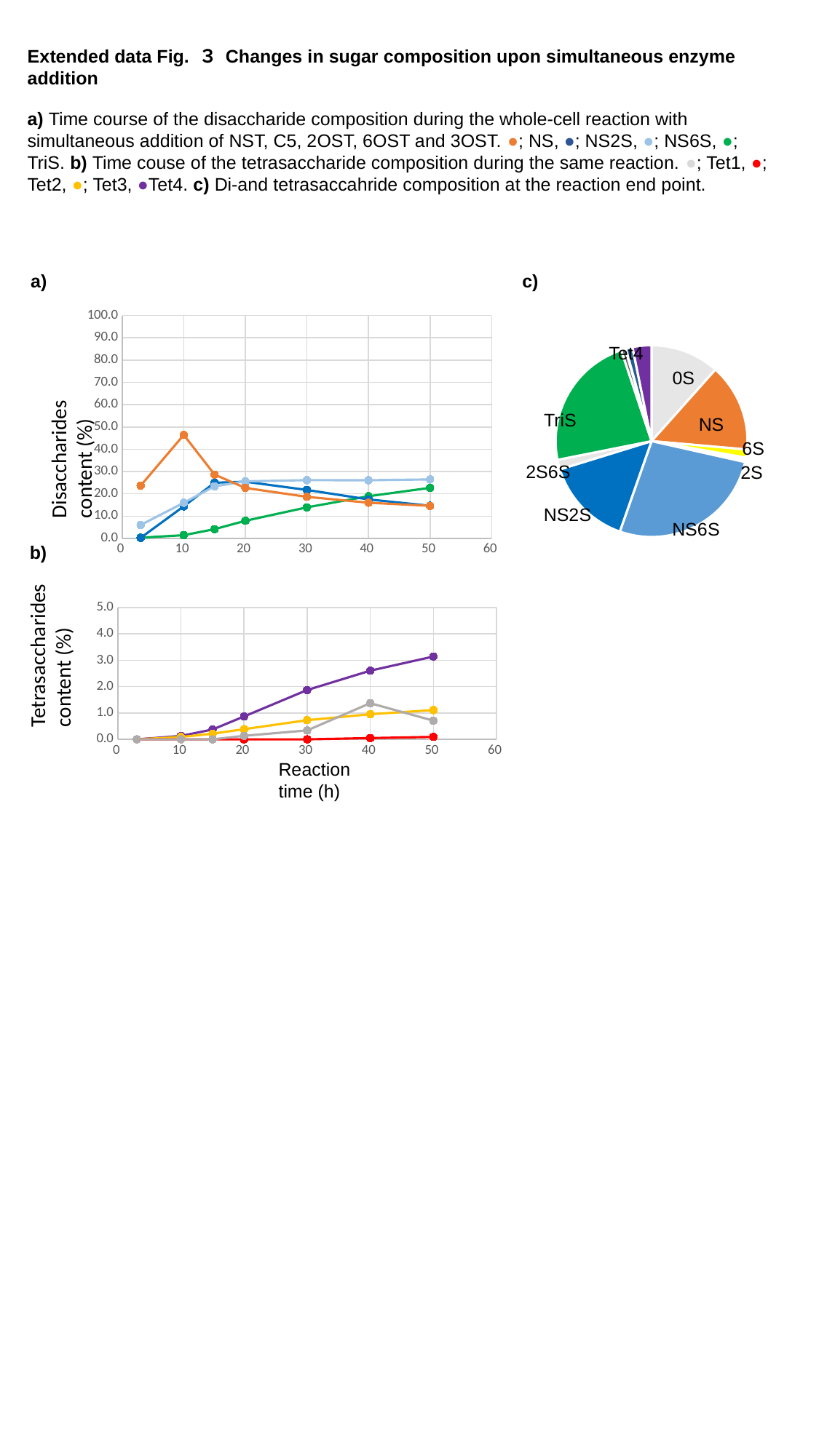
In chart b), is the value for Tet1 (grey) at 40 h greater or less than 1.0? greater In chart a), is the value for NS (orange) at 10 h greater or less than 40.0? greater In chart a), is the value for TriS (green) at 50 h greater or less than 30.0? less What kind of chart is chart a) (Disaccharides content)? line chart What is the x-axis label shared by charts a) and b)? Reaction time (h) In chart b), which series has the highest value at 50 h? Tet4 In chart a), does the TriS (green) series rise or fall along the x axis? rise What kind of chart is chart c)? pie chart In chart c), which slice is the largest? NS6S In chart b), which series has the lowest value at 50 h? Tet2 In chart a), which series has the highest value at 10 h? NS